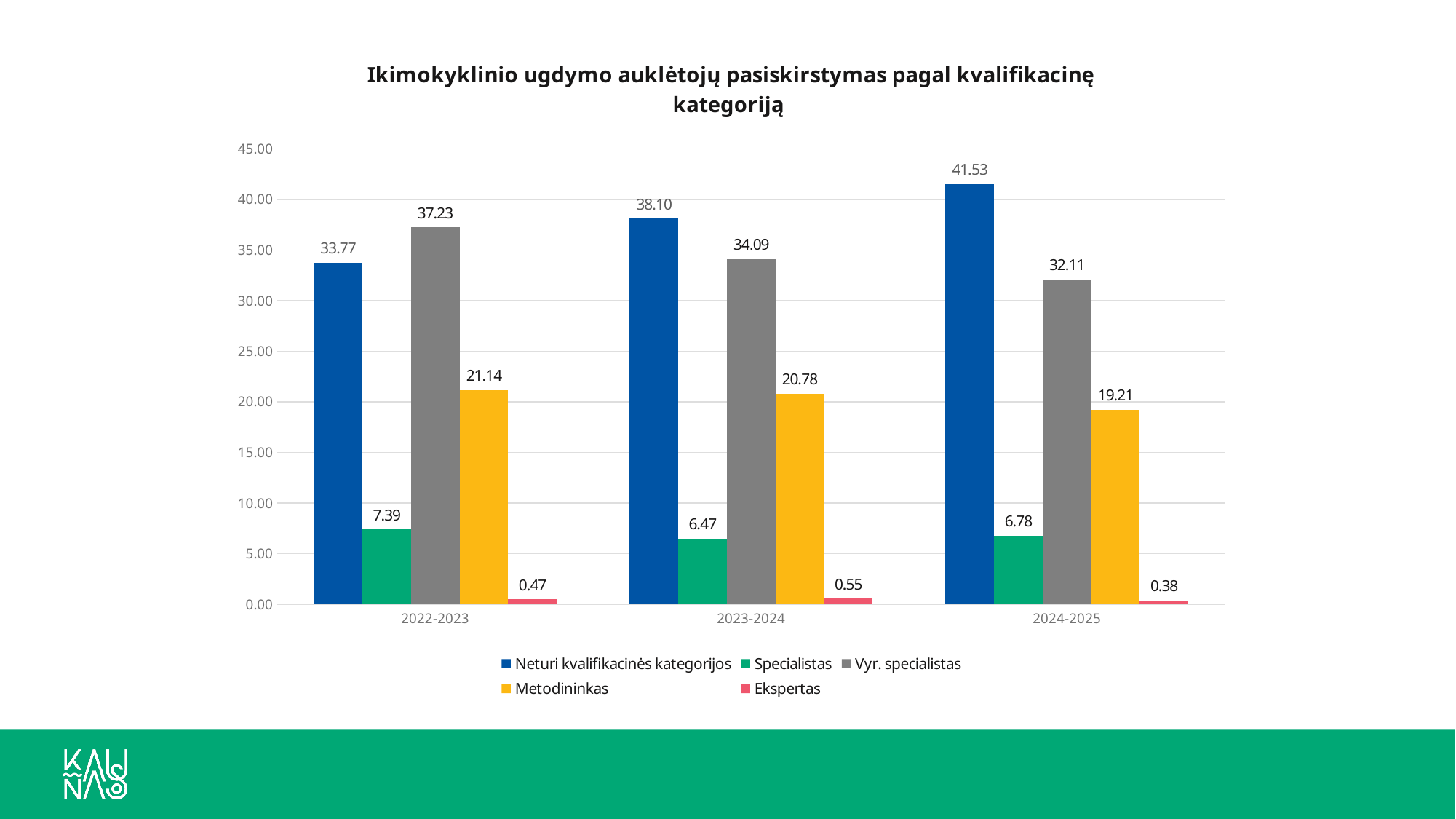
Which is larger in 2022-2023: Neturi kvalifikacinės kategorijos or Vyr. specialistas? Vyr. specialistas In which period is the value for Neturi kvalifikacinės kategorijos highest? 2024-2025 What is the value for Vyr. specialistas in 2022-2023? 37.23 How many periods are shown on the x axis? 3 How many series does the legend list? 5 Does the value for Vyr. specialistas rise or fall from 2022-2023 to 2024-2025? Fall In which period is the value for Specialistas lowest? 2023-2024 What is the value for Metodininkas in 2024-2025? 19.21 What is the value for Ekspertas in 2023-2024? 0.55 What is the value for Neturi kvalifikacinės kategorijos in 2024-2025? 41.53 What kind of chart is shown on the slide? Bar chart What is the difference between Neturi kvalifikacinės kategorijos and Vyr. specialistas in 2023-2024? 4.01